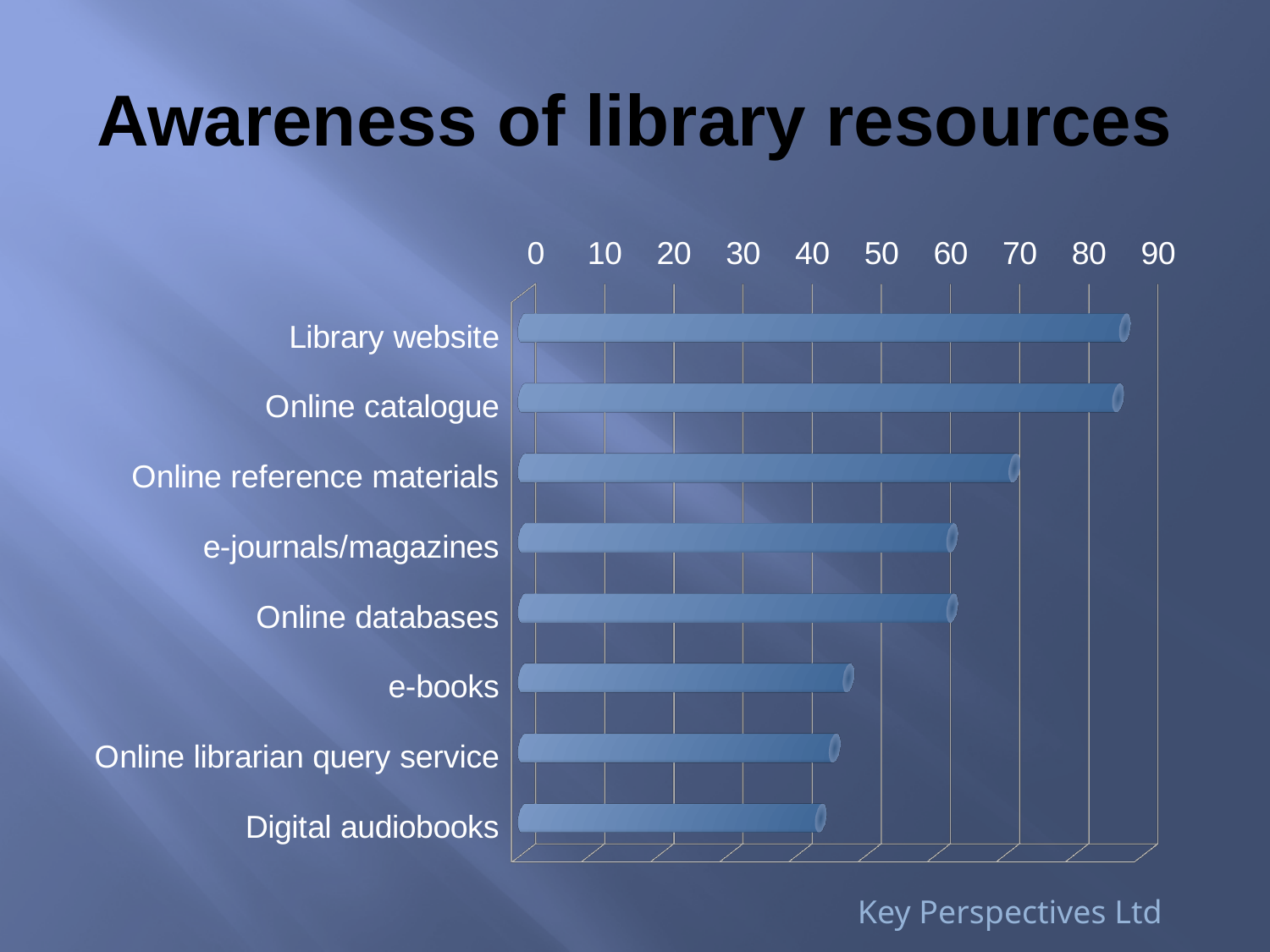
Is the value for Library website greater or less than 80? greater How many library resources are listed as categories in the chart? 8 Which has a higher value, Online reference materials or e-books? Online reference materials What kind of chart is shown on the slide? bar chart Is the value for e-books greater or less than 50? less Is the value for Digital audiobooks greater or less than 50? less Which has a higher value, Library website or Digital audiobooks? Library website Which has a higher value, Online catalogue or e-journals/magazines? Online catalogue What is the highest value shown on the chart's axis? 90 What is the title of the slide containing the chart? Awareness of library resources